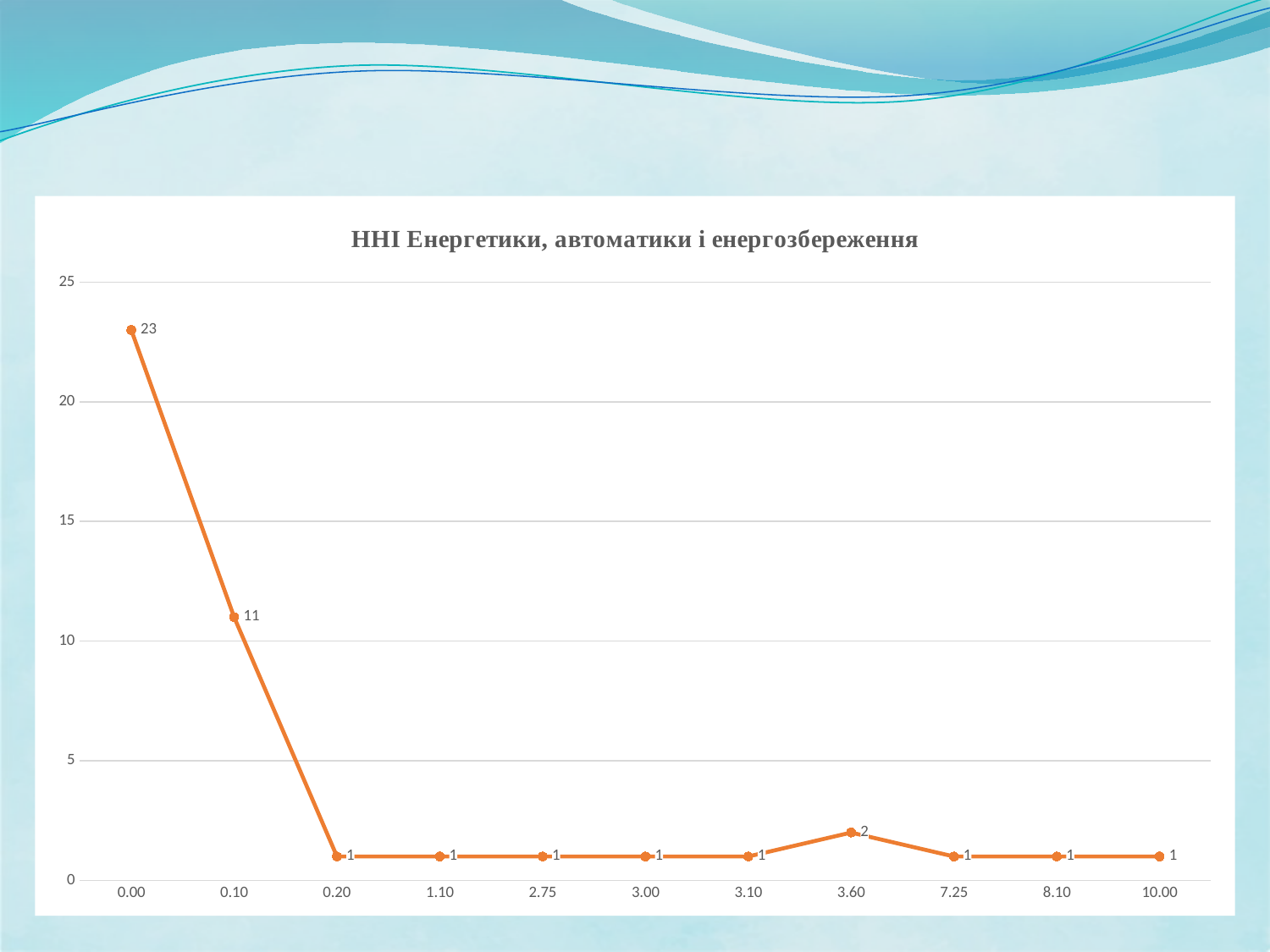
What is the value at the category 0.00? 23 What is the title of the chart? ННІ Енергетики, автоматики і енергозбереження Is the value at 0.10 greater or less than 10? greater Does the line generally rise or fall from 0.00 to 0.20 along the x axis? fall What is the value at the category 3.60? 2 Which is larger, the value at 3.60 or the value at 7.25? 3.60 How many data points are plotted on the chart? 11 What type of chart is shown on the slide? line chart What is the value at the category 10.00? 1 What is the value at the category 0.10? 11 Which category has the highest value? 0.00 What is the difference between the values at 0.00 and 0.10? 12